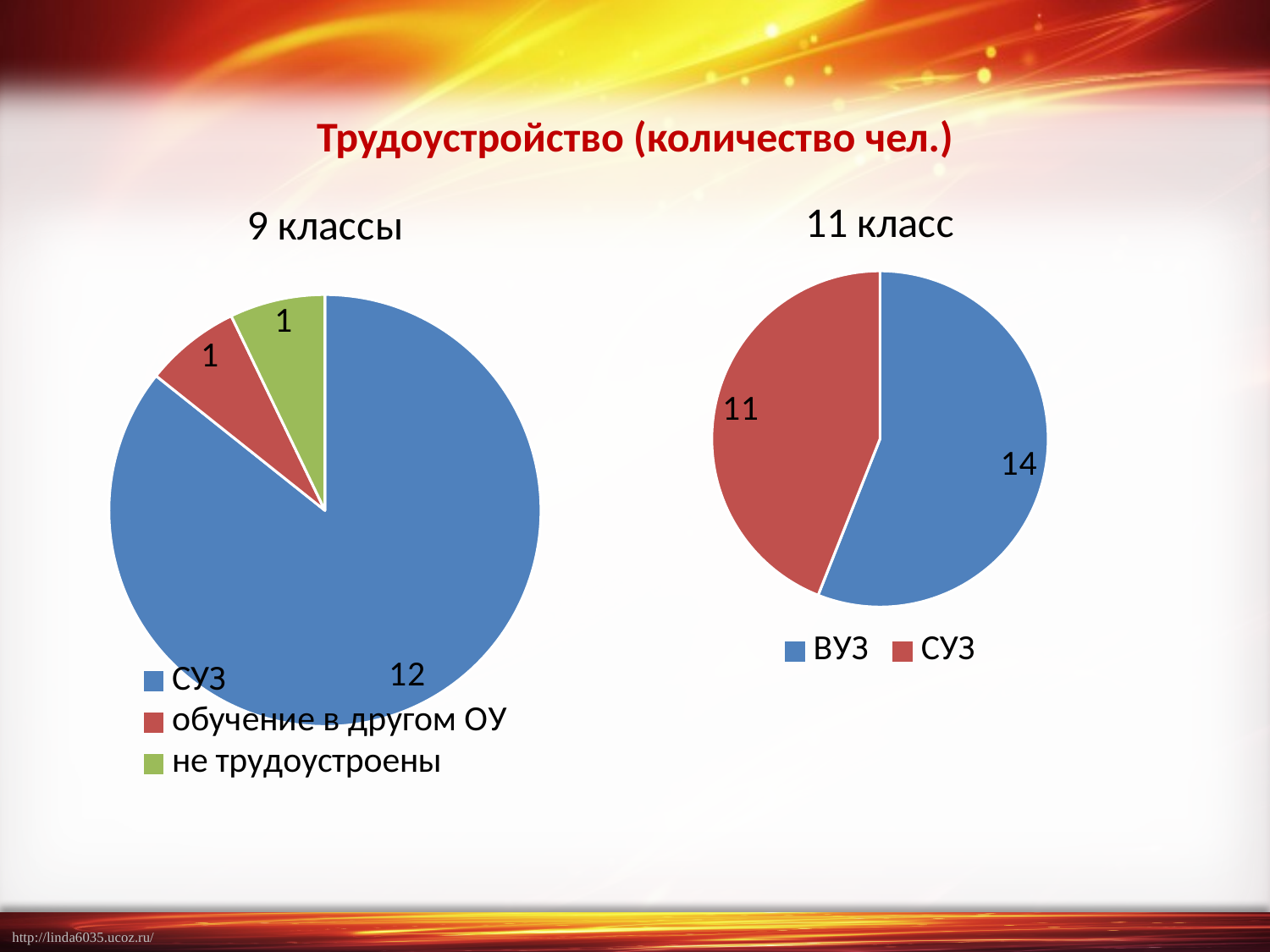
In the "11 класс" chart, which is larger, ВУЗ or СУЗ? ВУЗ What type of chart is the "11 класс" chart? Pie chart In the "9 классы" chart, which category has the largest slice? СУЗ In the "11 класс" chart, what share of the total does ВУЗ represent? 56% In the "11 класс" chart, which category has the smaller slice? СУЗ How many categories does the "9 классы" chart show? 3 In the "11 класс" chart, what is the difference between the ВУЗ and СУЗ values? 3 In the "9 классы" chart, what is the difference between the СУЗ value and the обучение в другом ОУ value? 11 In the "11 класс" chart, what is the value for СУЗ? 11 In the "9 классы" chart, what is the value for не трудоустроены? 1 In the "11 класс" chart, what is the value for ВУЗ? 14 In the "9 классы" chart, what is the value for СУЗ? 12